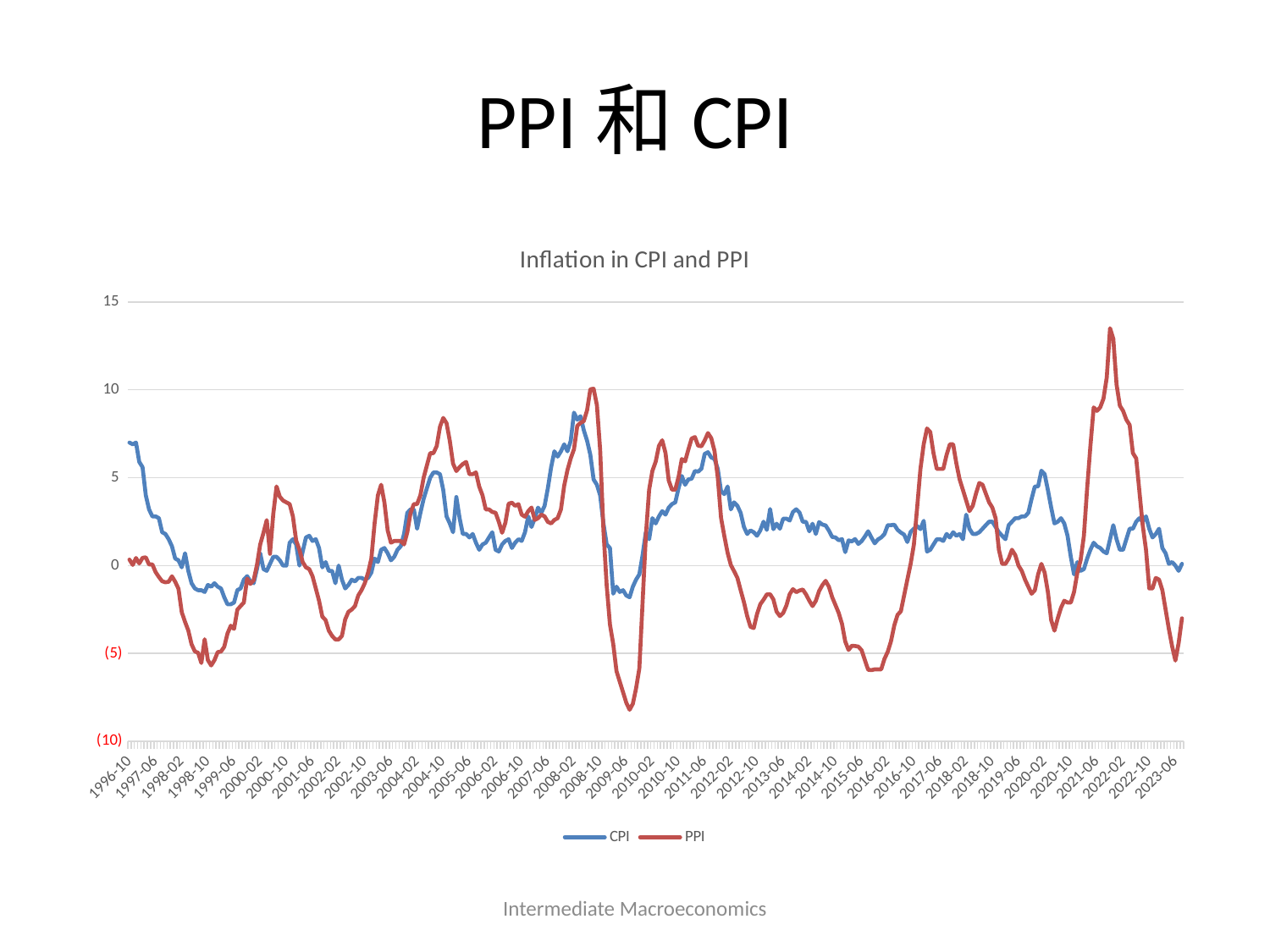
What is the title of the chart? Inflation in CPI and PPI Is the value for PPI around 2021-10 greater or less than 10? greater How many series does the legend list? 2 Which series reaches the lowest point on the chart, CPI or PPI? PPI Around 2009-06, which series has the higher value, CPI or PPI? CPI Does the CPI series rise or fall between 1996-10 and 1998-10? fall What kind of chart is shown on the slide? line chart Is the value for CPI around 2009-06 greater or less than 0? less Which series reaches the highest peak on the chart, CPI or PPI? PPI Is the value for PPI around 2009-06 greater or less than (5)? less Which colour is used for the PPI series? red